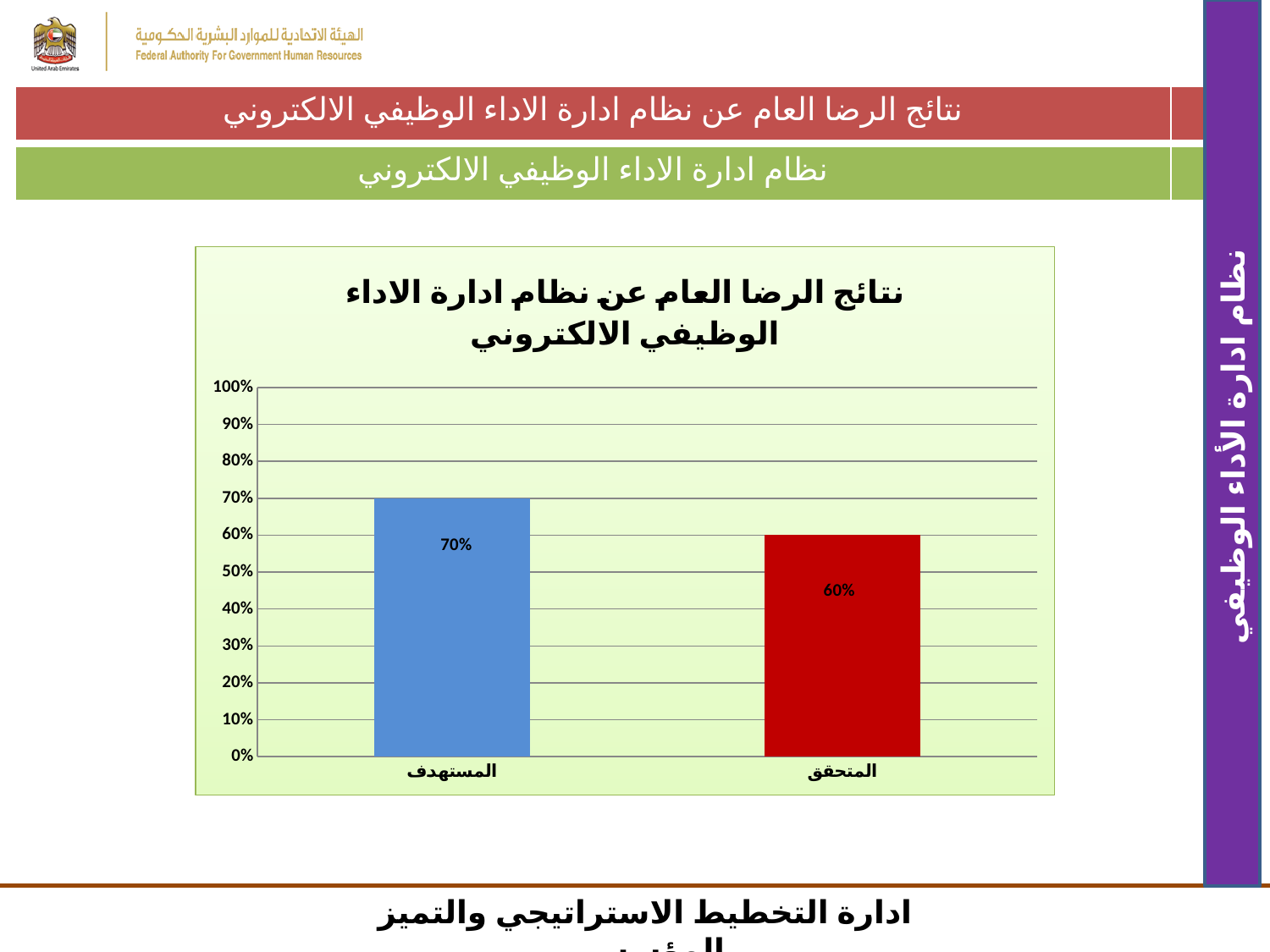
Is the value for المتحقق greater or less than 50%? greater Which category has the highest value? المستهدف What is the value for المستهدف? 70% What colour is the bar for المتحقق? red What kind of chart is shown on the slide? bar chart Which category has the lowest value? المتحقق Is the value for المستهدف greater or less than 80%? less What is the difference between the values for المستهدف and المتحقق? 10% Which is larger, the value for المستهدف or the value for المتحقق? المستهدف How many categories are shown on the x axis? 2 What is the value for المتحقق? 60% What is the title of the chart? نتائج الرضا العام عن نظام ادارة الاداء الوظيفي الالكتروني